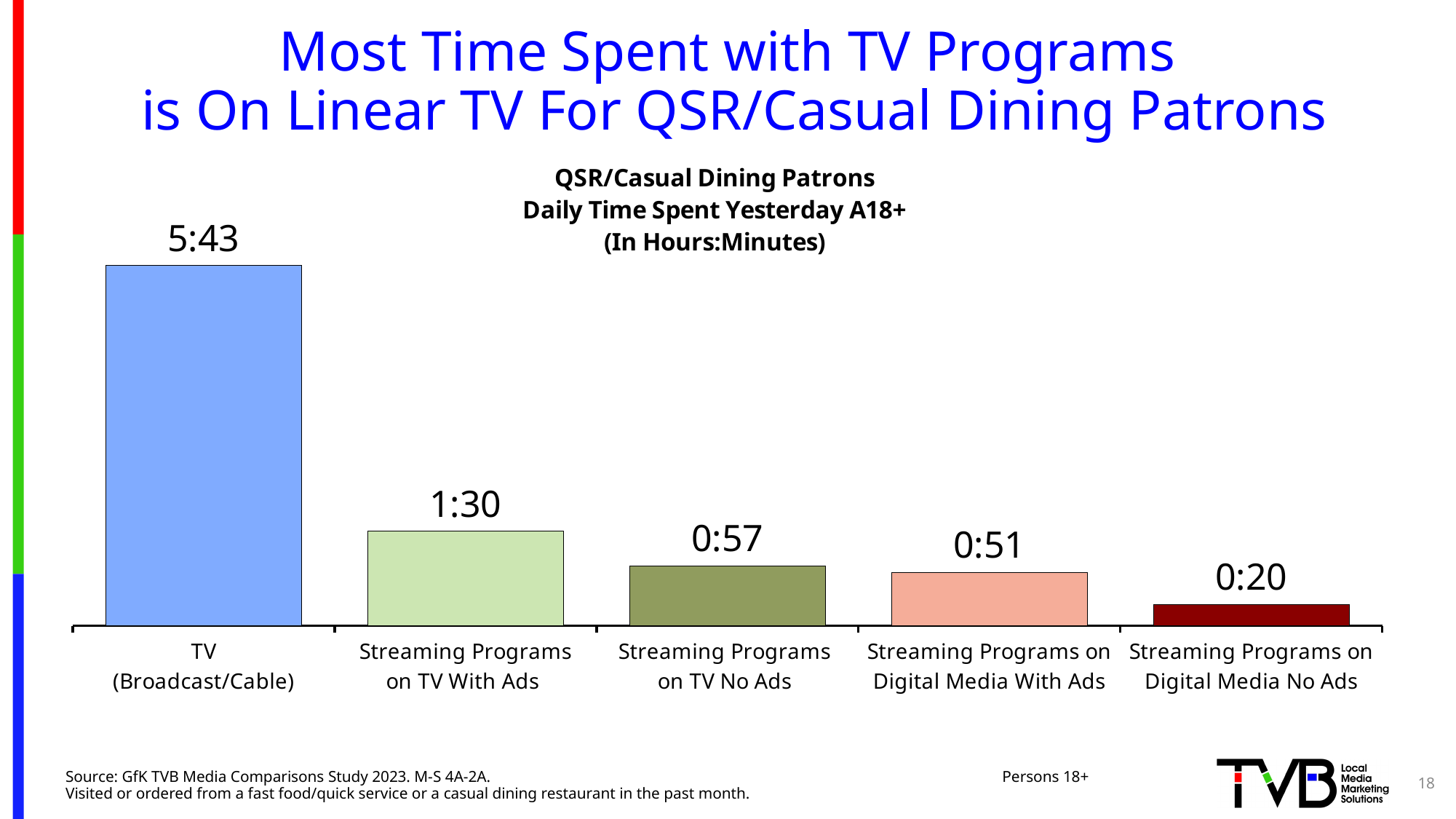
What is the daily time spent for Streaming Programs on Digital Media No Ads? 0:20 What is the difference between Streaming Programs on TV No Ads and Streaming Programs on Digital Media With Ads? 0:06 What is the daily time spent for TV (Broadcast/Cable)? 5:43 Which category has the highest daily time spent? TV (Broadcast/Cable) In what units are the values in the chart expressed, according to the chart title? Hours:Minutes Which is larger: Streaming Programs on TV With Ads or Streaming Programs on Digital Media With Ads? Streaming Programs on TV With Ads How many categories are shown in the chart? 5 What type of chart is shown on the slide? Bar chart How much more time is spent with TV (Broadcast/Cable) than with Streaming Programs on TV With Ads? 4:13 What is the daily time spent for Streaming Programs on TV With Ads? 1:30 What is the daily time spent for Streaming Programs on TV No Ads? 0:57 Which category has the lowest daily time spent? Streaming Programs on Digital Media No Ads